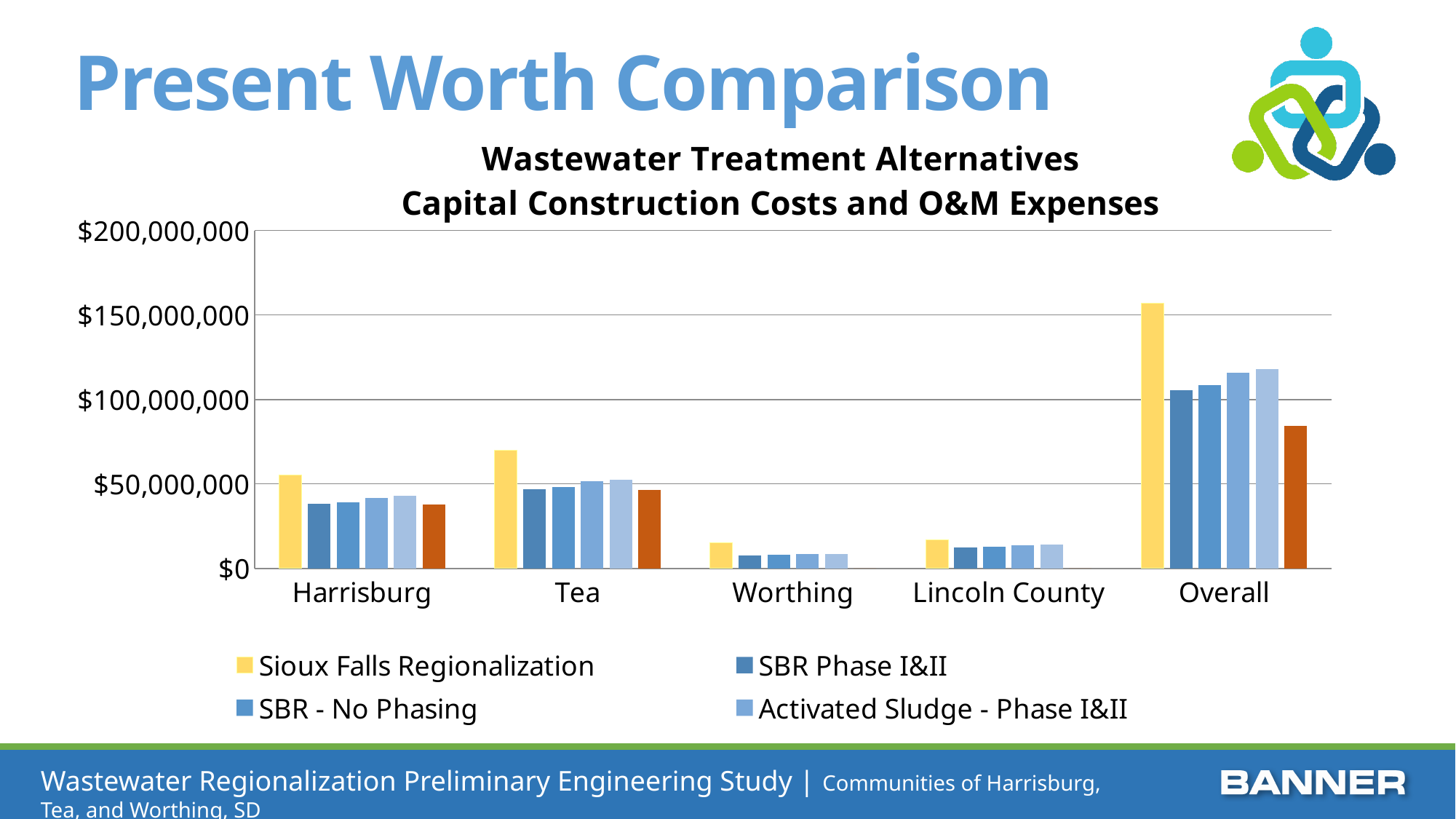
How many series does the chart's legend list? 4 For the Overall category, which is larger: Sioux Falls Regionalization or SBR Phase I&II? Sioux Falls Regionalization Is the SBR Phase I&II value for Tea greater or less than $50,000,000? less How many categories are shown along the x axis of the chart? 5 Is the Sioux Falls Regionalization value for Overall greater or less than $150,000,000? greater Which category has the highest Sioux Falls Regionalization bar? Overall For Sioux Falls Regionalization, which is larger: Harrisburg or Tea? Tea Is the Sioux Falls Regionalization value for Worthing greater or less than $50,000,000? less What kind of chart is shown on the slide? bar chart What is the title of the chart? Wastewater Treatment Alternatives Capital Construction Costs and O&M Expenses